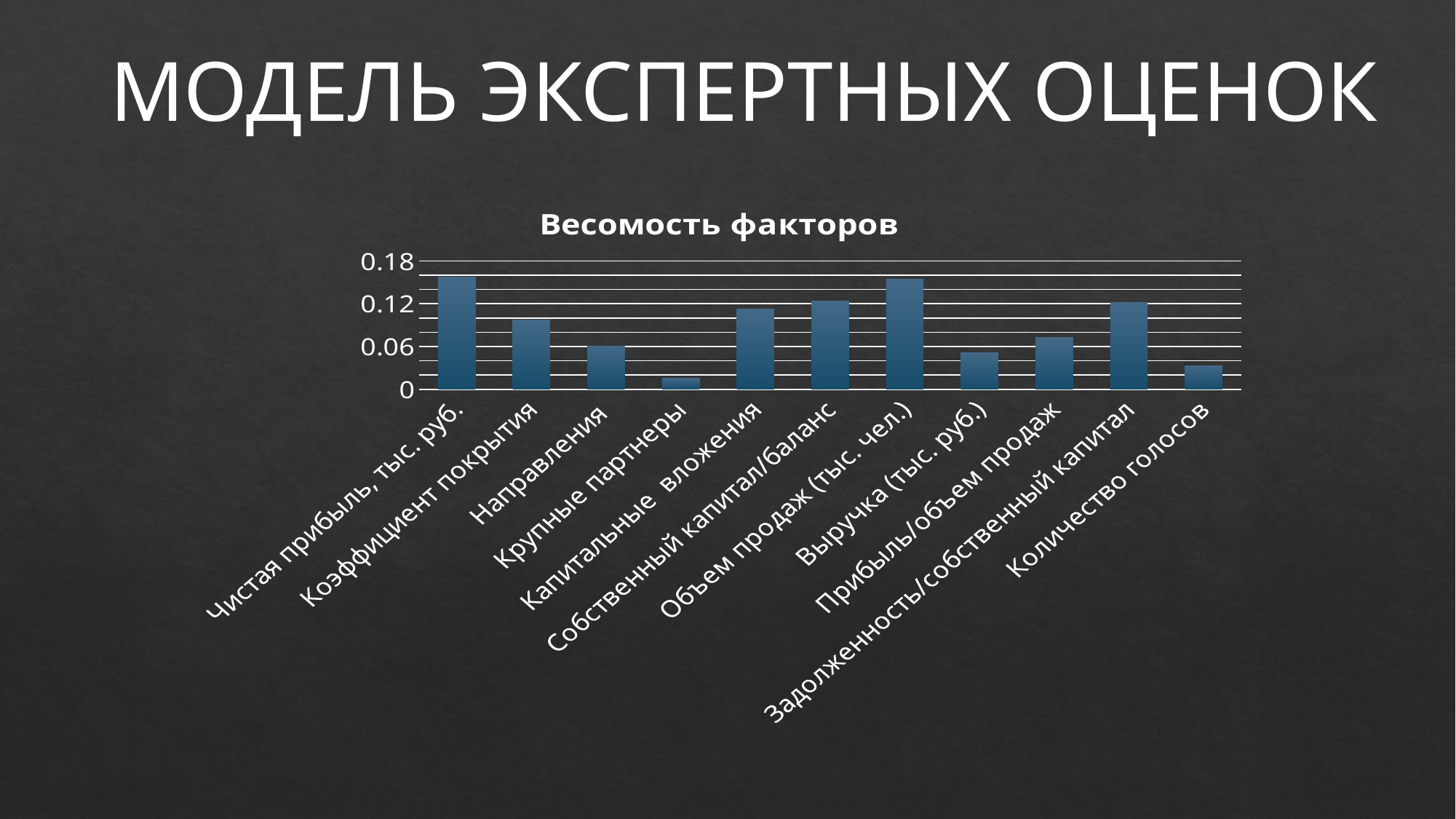
Is the value for Чистая прибыль, тыс. руб. greater or less than 0.12? greater Which is larger, the value for Коэффициент покрытия or the value for Выручка (тыс. руб.)? Коэффициент покрытия Which category has the lowest value in the chart? Крупные партнеры Is the value for Крупные партнеры greater or less than 0.06? less Which is larger, the value for Чистая прибыль, тыс. руб. or the value for Направления? Чистая прибыль, тыс. руб. What is the title of the chart? Весомость факторов Is the value for Коэффициент покрытия greater or less than 0.06? greater What kind of chart is shown on the slide? bar chart How many categories are plotted in the chart? 11 Which is larger, the value for Задолженность/собственный капитал or the value for Количество голосов? Задолженность/собственный капитал